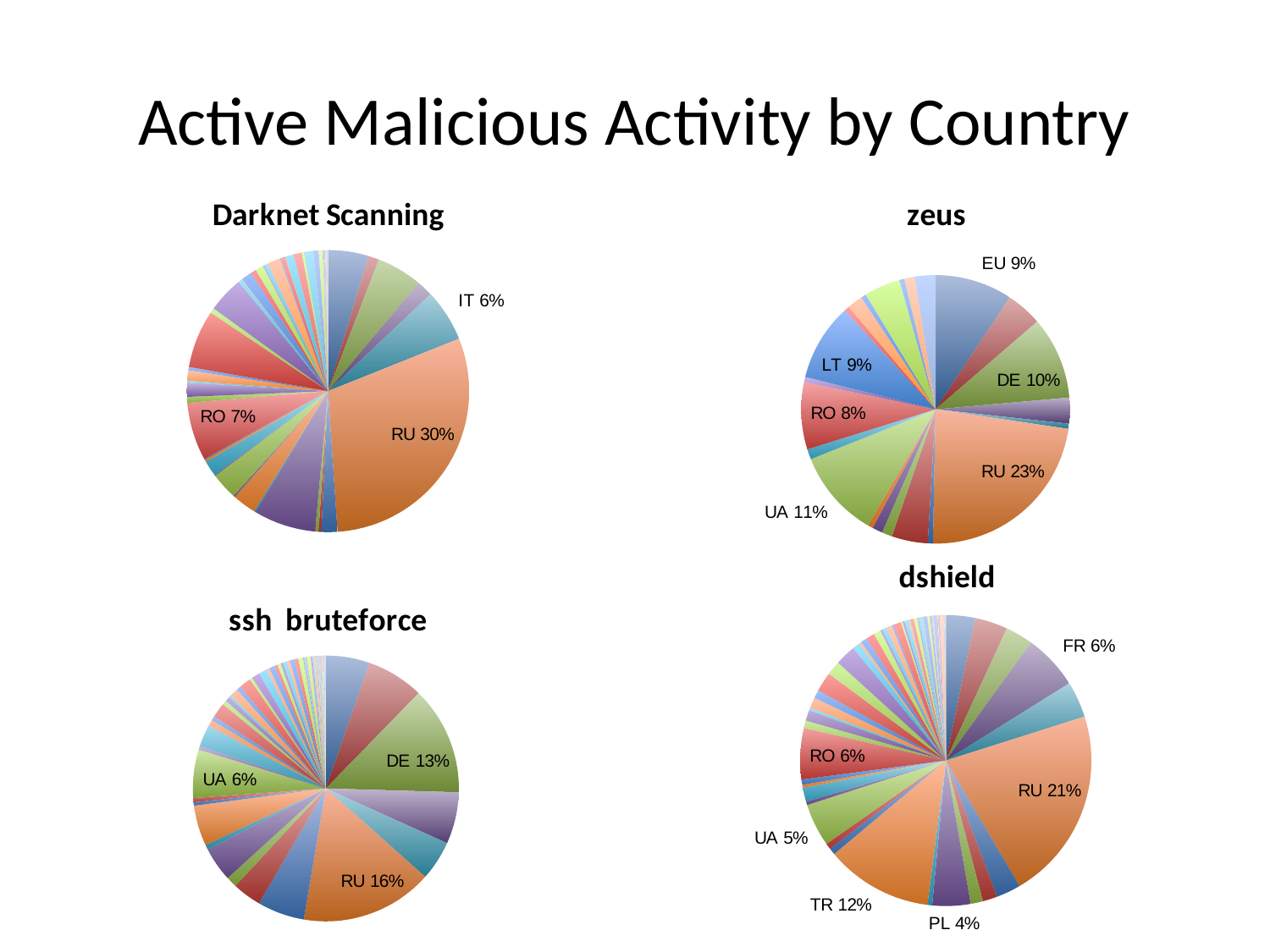
In the dshield chart, what is the difference between the RU share and the TR share? 9% In the Darknet Scanning chart, what share does RU have? 30% What kind of chart is the Darknet Scanning chart? Pie chart In the zeus chart, what share does RU have? 23% In the Darknet Scanning chart, what share does RO have? 7% In the ssh bruteforce chart, what share does DE have? 13% In the zeus chart, what share does UA have? 11% In the dshield chart, what share does PL have? 4% In the zeus chart, what is the difference between the DE share and the RO share? 2% In the ssh bruteforce chart, which is larger, the RU slice or the UA slice? RU In the zeus chart, which labelled country has the largest slice? RU In the dshield chart, what share does TR have? 12%